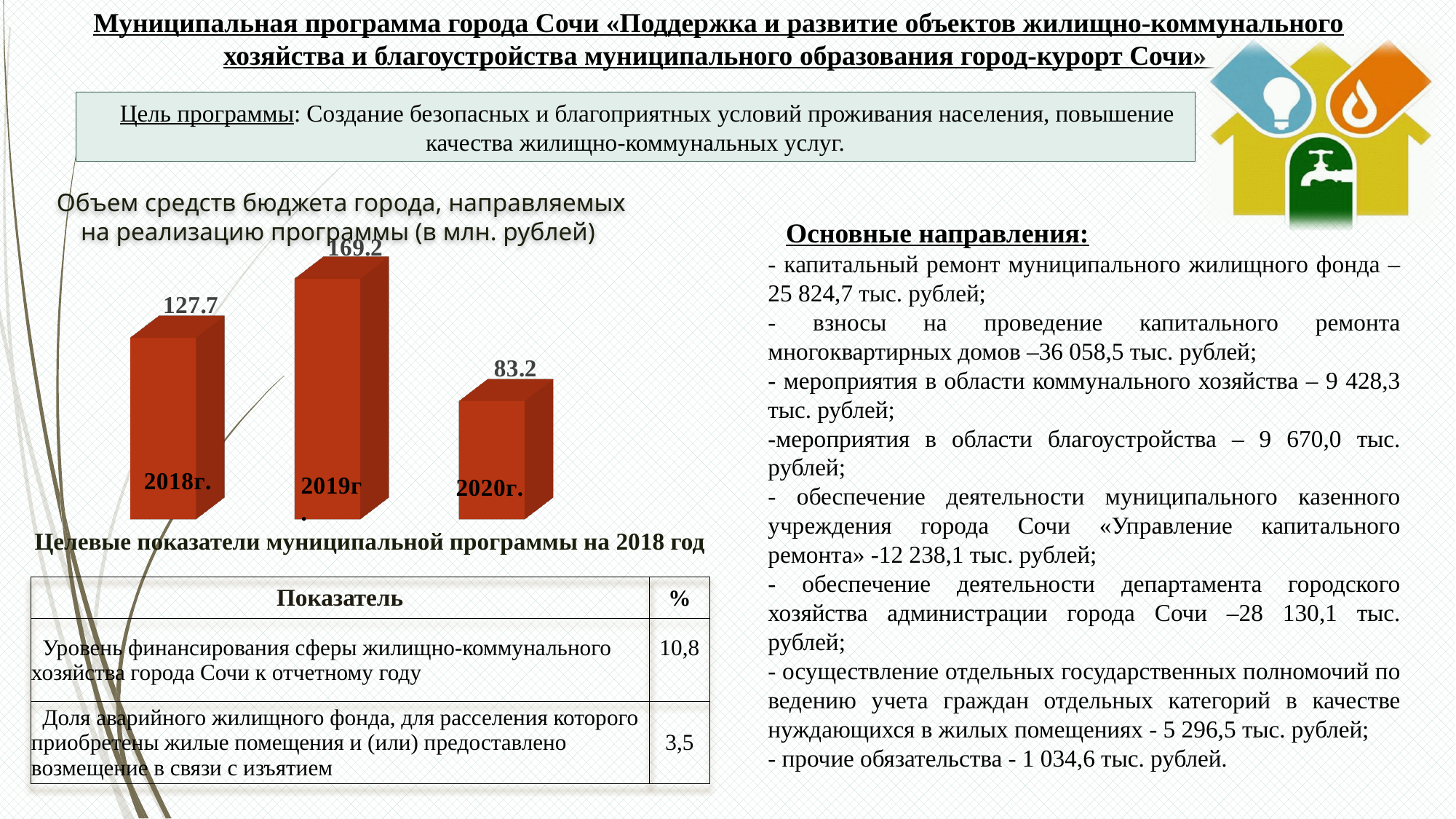
Which year has the highest value in the chart? 2019г. Which is larger, the value for 2018г. or the value for 2020г.? 2018г. What is the value for 2019г. in the chart? 169.2 What kind of chart is shown on the slide? Bar chart What is the difference between the values for 2018г. and 2020г.? 44.5 In what units are the values in the chart expressed, according to its title? млн. рублей What is the difference between the values for 2019г. and 2018г.? 41.5 Does the value rise or fall from 2019г. to 2020г.? Fall What is the value for 2020г. in the chart? 83.2 What is the value for 2018г. in the chart 'Объем средств бюджета города, направляемых на реализацию программы (в млн. рублей)'? 127.7 Which year has the lowest value in the chart? 2020г. How many years (categories) are shown in the chart? 3